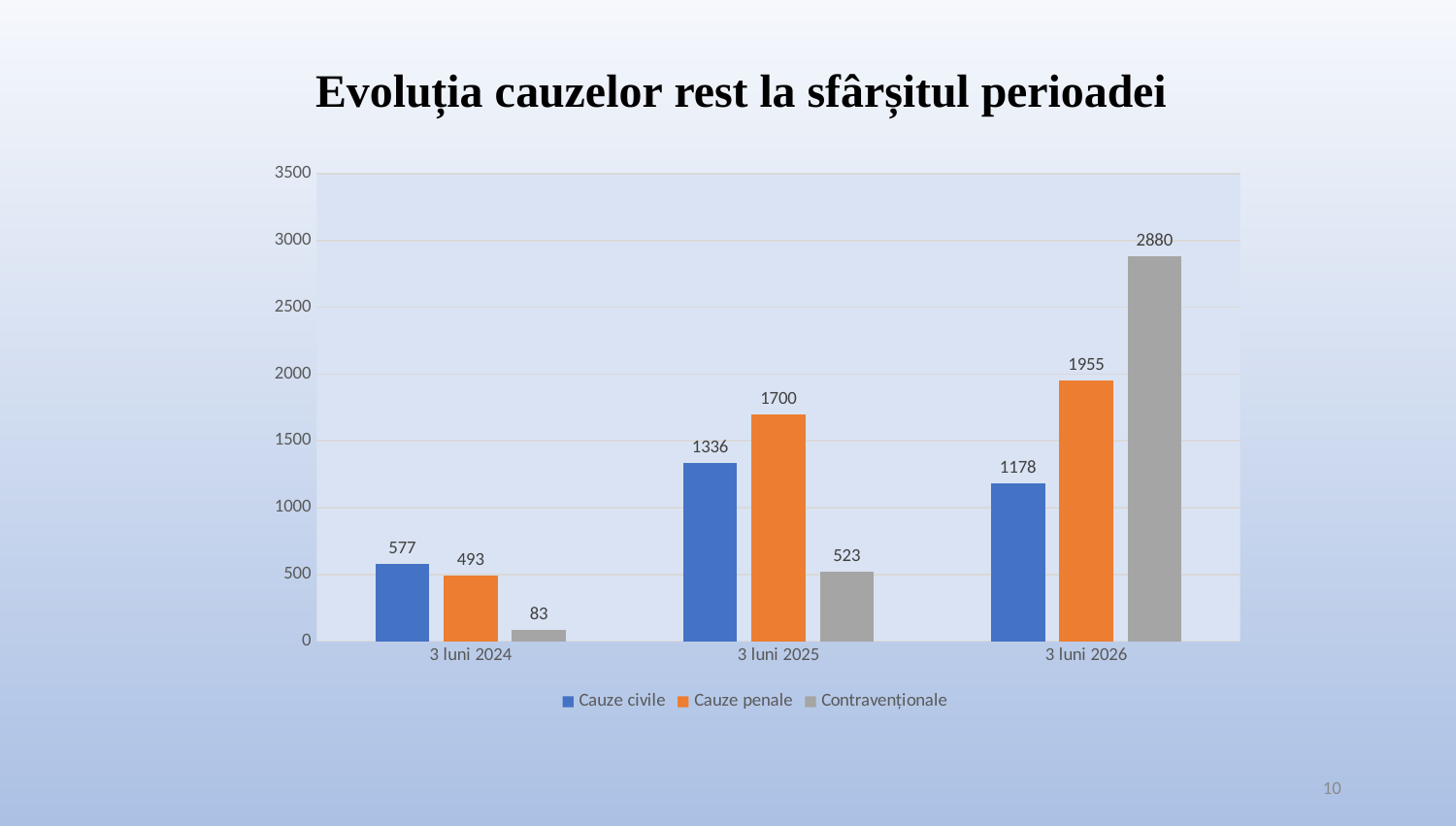
How many periods are shown on the x axis? 3 What kind of chart is shown on the slide? Bar chart Is the value for Contravenționale in 3 luni 2026 greater or less than 2500? greater Does the value for Contravenționale rise or fall from 3 luni 2024 to 3 luni 2026? Rise What is the value for Cauze penale in 3 luni 2025? 1700 How many series does the legend list? 3 Which period has the highest value for Contravenționale? 3 luni 2026 Which is larger in 3 luni 2024: Cauze civile or Cauze penale? Cauze civile Which period has the lowest value for Cauze civile? 3 luni 2024 What is the value for Cauze civile in 3 luni 2026? 1178 What is the difference between Cauze penale in 3 luni 2026 and 3 luni 2025? 255 What is the value for Contravenționale in 3 luni 2024? 83